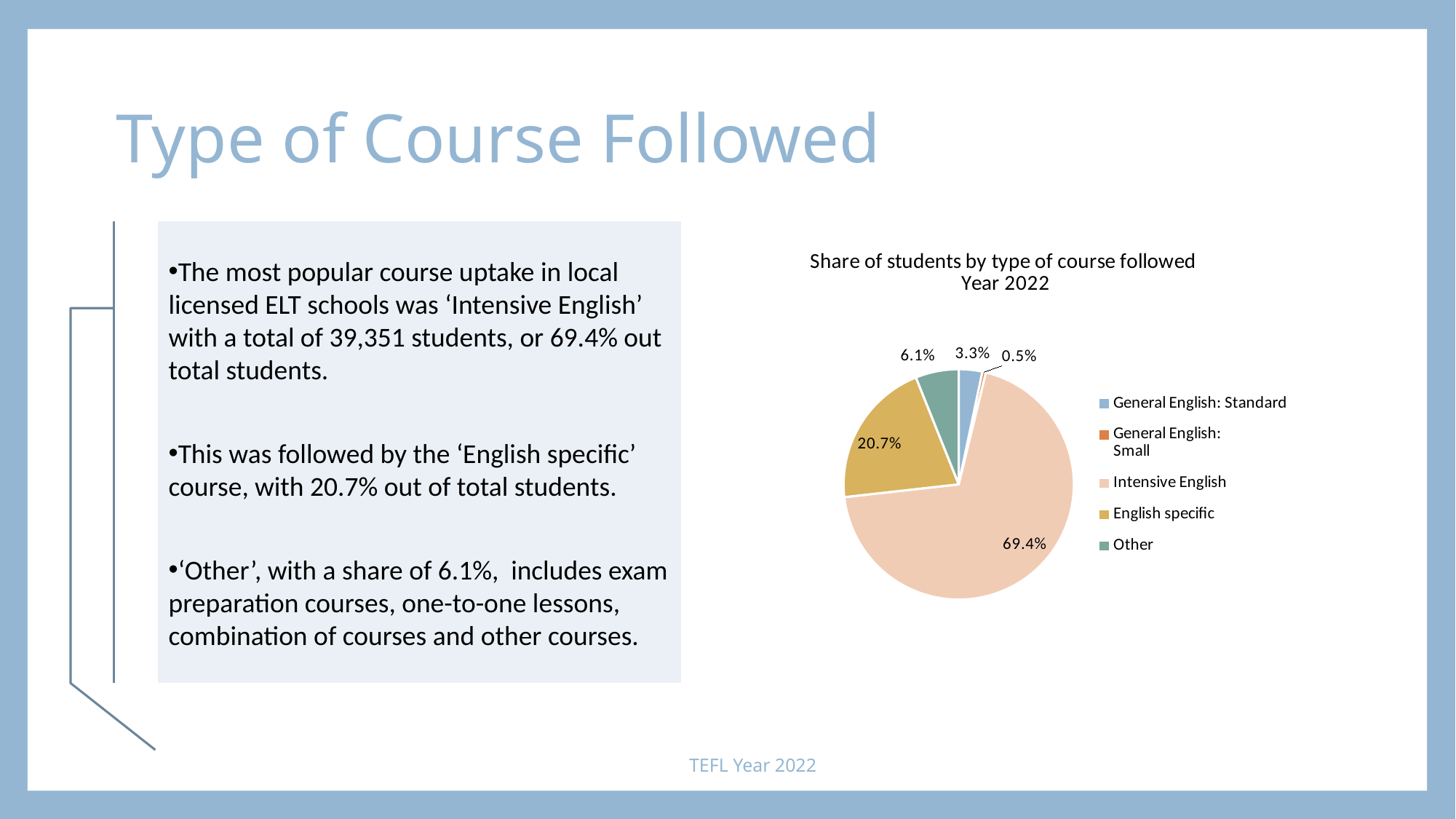
How many categories does the pie chart show? 5 Which type of course has the largest share of students? Intensive English What share of students followed General English: Standard? 3.3% What share of students followed the English specific course? 20.7% Which type of course has the smallest share of students? General English: Small What is the title of the chart? Share of students by type of course followed Year 2022 What share of students followed General English: Small? 0.5% What is the difference in share between Intensive English and English specific? 48.7% What share of students is shown for the Other category? 6.1% What share of students followed the Intensive English course? 69.4% Which has a larger share of students, Other or General English: Standard? Other What kind of chart is shown on the slide? Pie chart